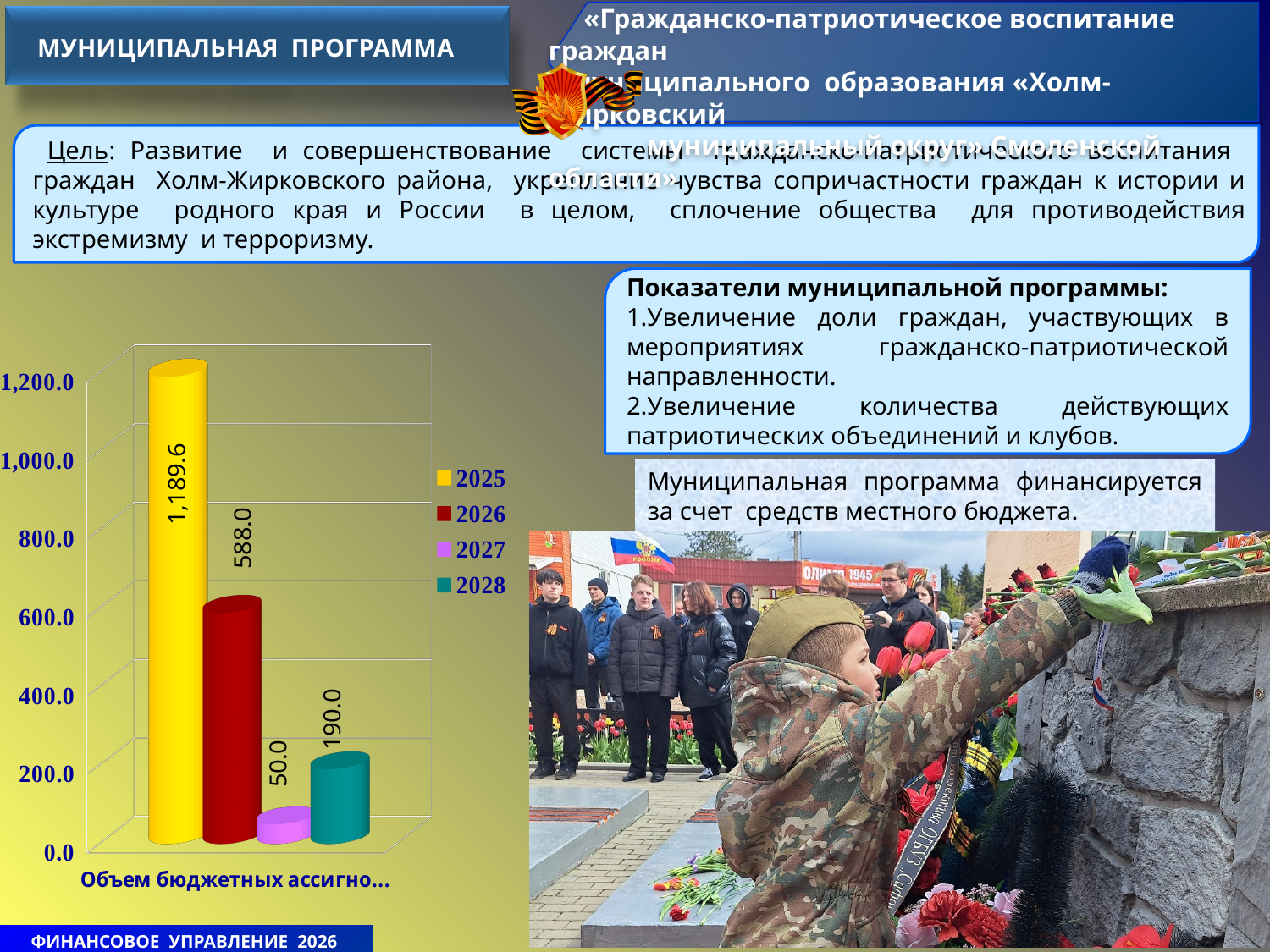
What is the value for 2028 in the chart? 190.0 Which year has the highest value in the chart? 2025 Which year has the lowest value in the chart? 2027 Which is larger, the value for 2026 or the value for 2028? 2026 What is the difference between the values for 2025 and 2026? 601.6 What is the value for 2027 in the chart? 50.0 How many series does the legend list? 4 What is the value for 2025 in the chart? 1,189.6 What kind of chart is shown on the slide? bar chart What is the difference between the values for 2028 and 2027? 140.0 Is the value for 2026 greater or less than 600.0? less What is the value for 2026 in the chart? 588.0